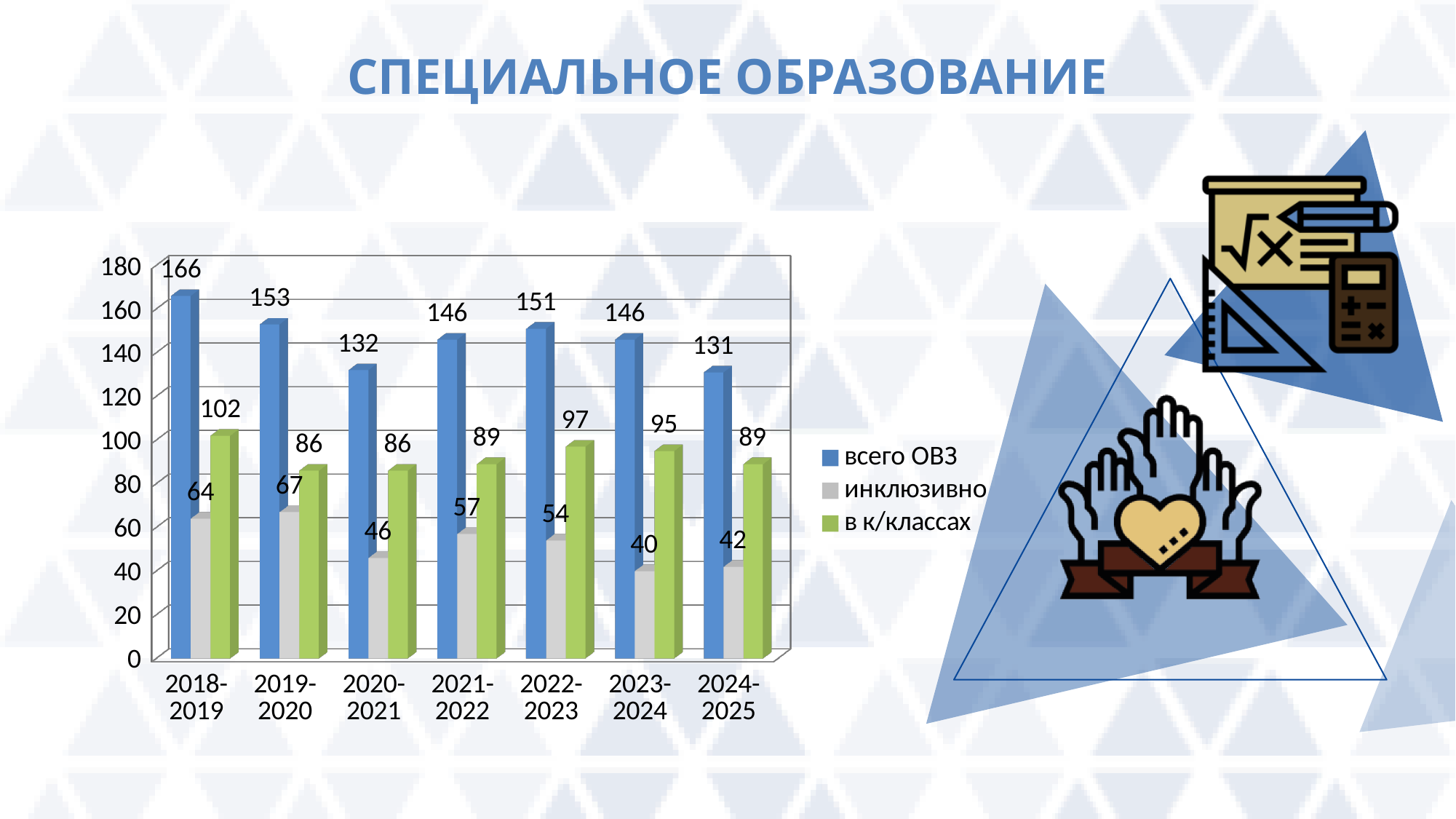
Which is larger in 2019-2020: 'инклюзивно' or 'в к/классах'? в к/классах Is the value of 'всего ОВЗ' for 2020-2021 greater or less than 140? less What is the difference between 'всего ОВЗ' in 2018-2019 and in 2024-2025? 35 How many series does the legend list? 3 What kind of chart is shown on the slide? bar chart What is the value of 'инклюзивно' for 2020-2021? 46 What is the value of 'всего ОВЗ' for 2018-2019? 166 In which year is 'инклюзивно' the lowest? 2023-2024 How many school years are shown on the x axis? 7 What is the title of the slide? СПЕЦИАЛЬНОЕ ОБРАЗОВАНИЕ In which year is 'всего ОВЗ' the highest? 2018-2019 What is the value of 'в к/классах' for 2022-2023? 97